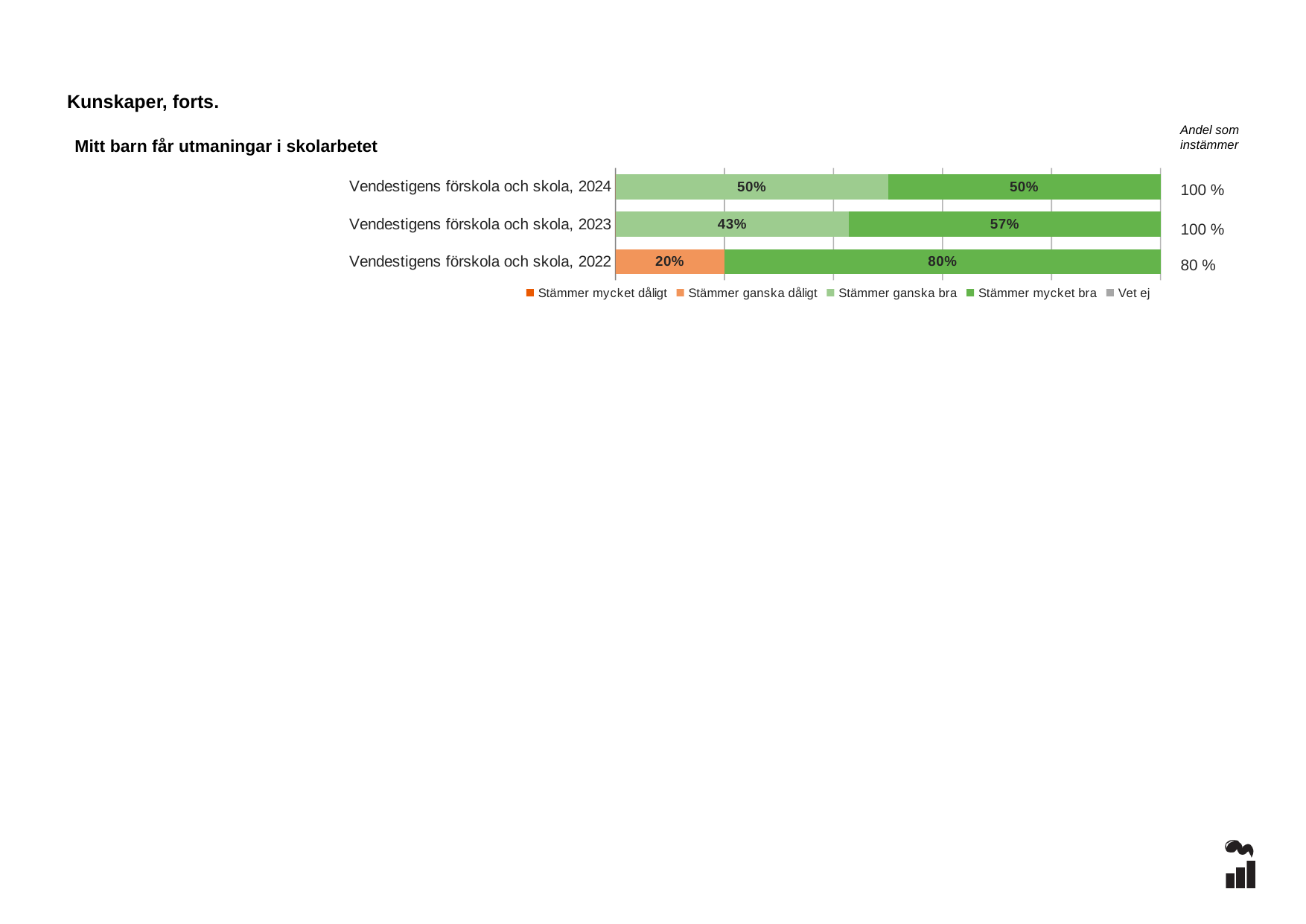
What is the value for "Stämmer mycket bra" for Vendestigens förskola och skola, 2024? 50% Which is larger: "Stämmer ganska bra" for 2024 or "Stämmer ganska bra" for 2023? 2024 How many bars (years) are shown in the chart? 3 What is the value for "Stämmer mycket bra" for Vendestigens förskola och skola, 2022? 80% How many series does the legend list? 5 What is the value for "Stämmer ganska bra" for Vendestigens förskola och skola, 2023? 43% What is the "Andel som instämmer" value shown for Vendestigens förskola och skola, 2022? 80 % Which year has the highest value for "Stämmer mycket bra"? Vendestigens förskola och skola, 2022 What is the difference between the "Stämmer mycket bra" values for 2022 and 2023? 23% Which year has the lowest value for "Stämmer mycket bra"? Vendestigens förskola och skola, 2024 What kind of chart is shown on the slide? Stacked bar chart What is the value for "Stämmer ganska dåligt" for Vendestigens förskola och skola, 2022? 20%